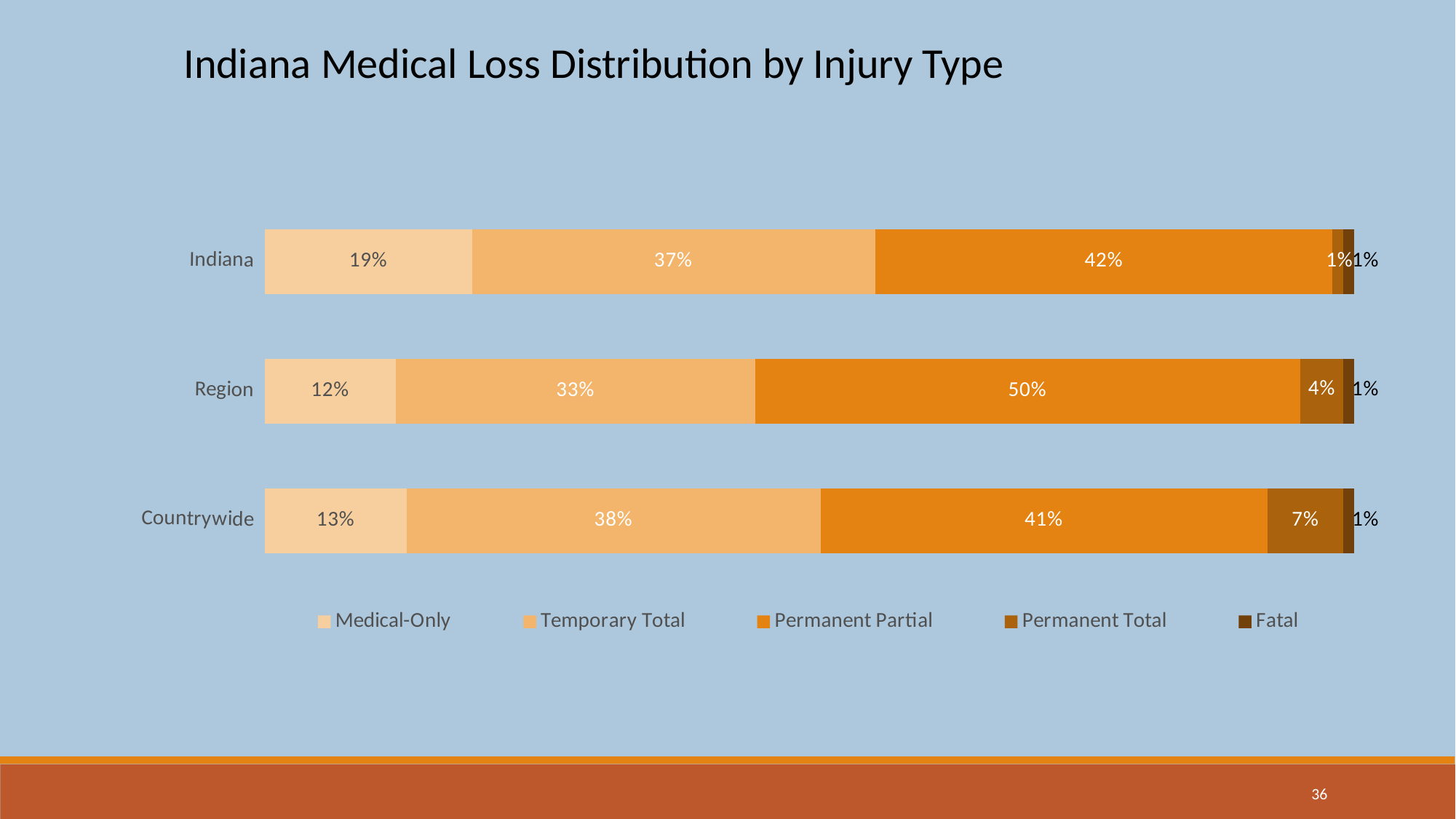
What is the Permanent Partial share for Region? 50% What is the Medical-Only share for Indiana? 19% What is the Temporary Total share for Countrywide? 38% Which category has the highest Permanent Partial share? Region Which category has the lowest Medical-Only share? Region How many series does the legend list? 5 Which is larger, the Temporary Total share for Indiana or for Region? Indiana What is the difference between the Permanent Partial shares for Region and Countrywide? 9% What kind of chart is shown on the slide? Stacked bar chart What is the total of the stacked bar for Indiana? 100% How many categories are shown on the chart? 3 What is the Permanent Total share for Countrywide? 7%